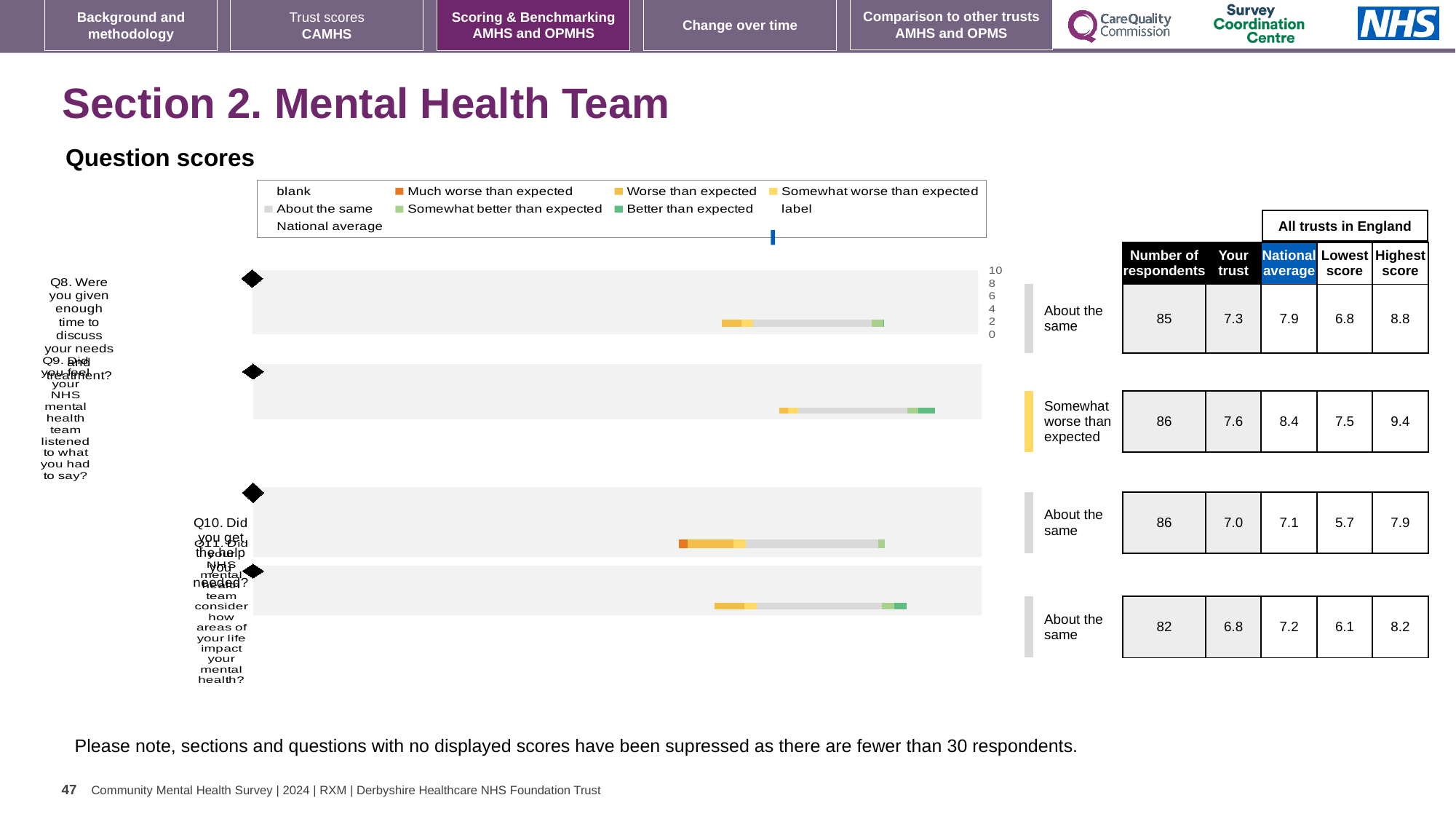
How many questions (bars) are plotted in the Question scores chart? 4 What kind of chart is shown under 'Question scores'? bar chart Which question is rated 'Somewhat worse than expected' in the chart? Q9 What is the difference between the national average and the 'Your trust' score for Q9? 0.8 What is the highest score among all trusts in England for Q10? 7.9 According to the table beside the chart, how many respondents answered Q11? 82 Which question has the highest 'Your trust' score in the table beside the chart? Q9 Which question has the lowest 'Your trust' score in the table beside the chart? Q11 For Q8, which is larger: the 'Your trust' score or the national average? National average According to the table beside the chart, what is the national average for Q9? 8.4 According to the table beside the chart, what is the 'Your trust' score for Q8? 7.3 In the chart legend, which colour represents 'Much worse than expected'? orange